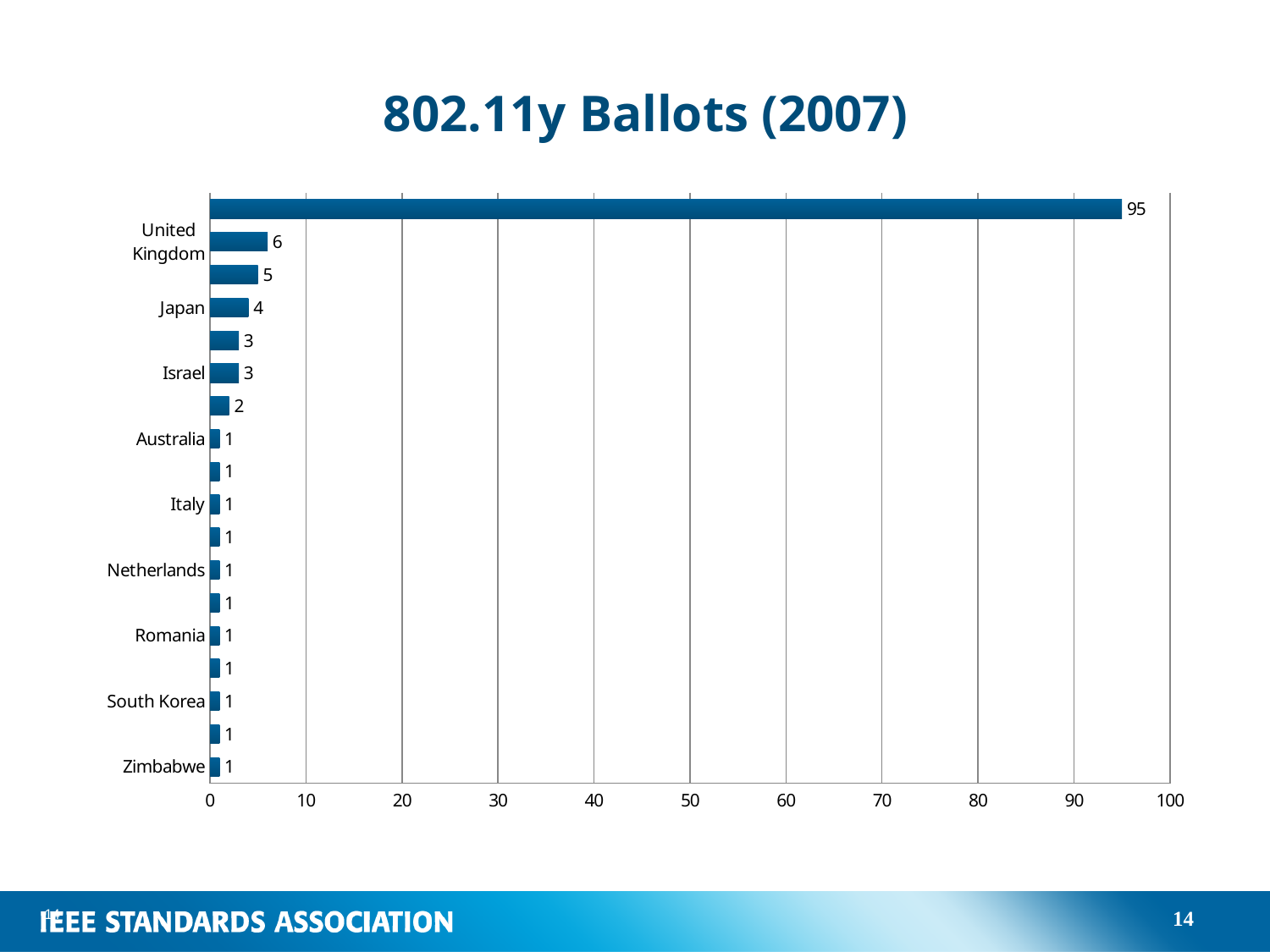
What is the value for Australia? 1 What is the largest value shown on the chart? 95 What is the value for Japan? 4 What is the value for Israel? 3 How many bars are plotted on the chart? 18 What is the value for Zimbabwe? 1 Which has a larger value, United Kingdom or Israel? United Kingdom What is the title of the chart? 802.11y Ballots (2007) What kind of chart is shown on the slide? bar chart What is the difference between the values for United Kingdom and Japan? 2 What is the value for United Kingdom? 6 Is the value of the longest bar greater or less than 90? greater